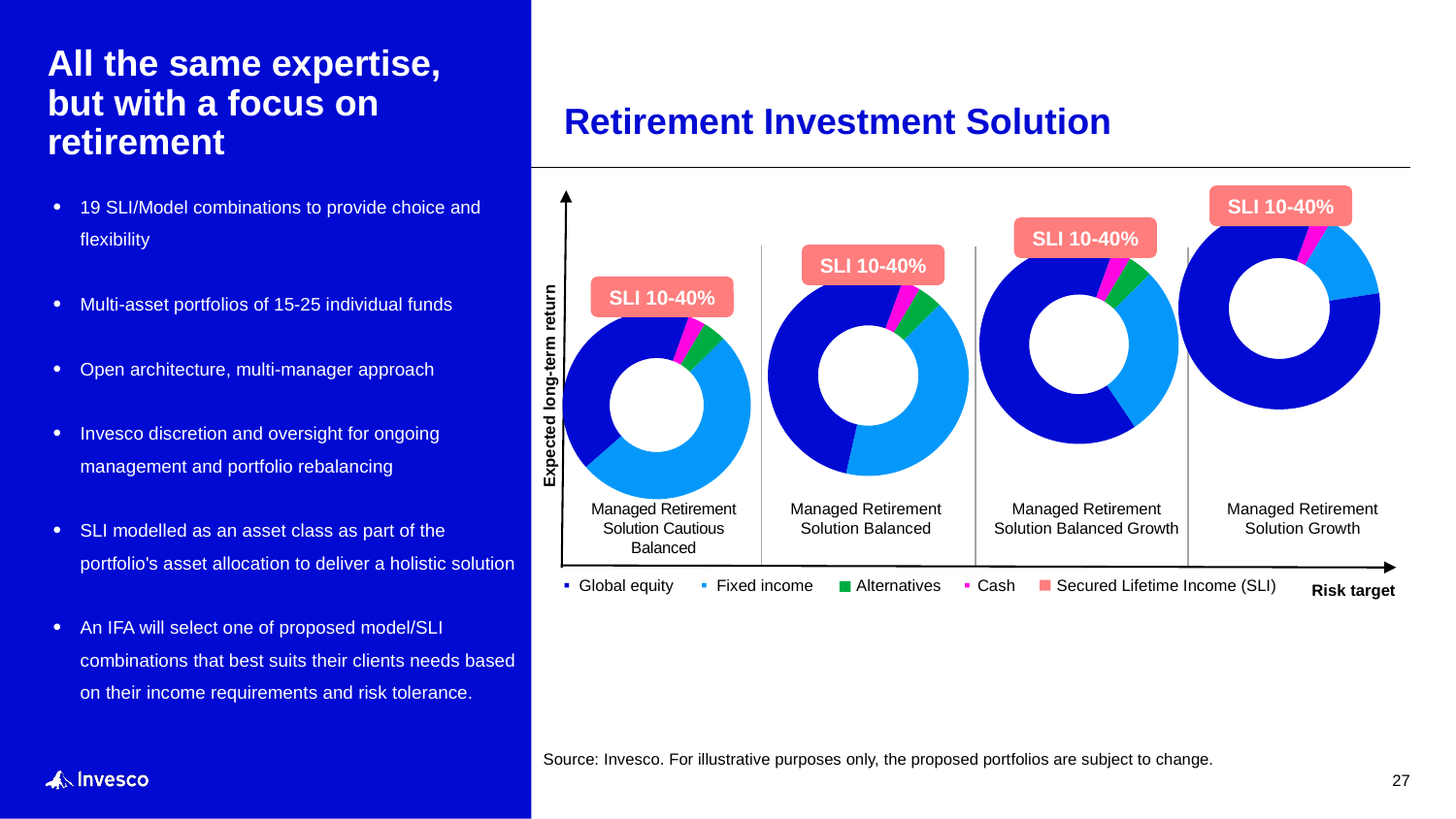
Which legend entry is shown in green? Alternatives In the Managed Retirement Solution Growth chart, which is larger: Global equity or Fixed income? Global equity How many portfolio charts are shown on the slide? 4 In the Managed Retirement Solution Growth chart, which asset class has the smallest slice? Cash In the Managed Retirement Solution Cautious Balanced chart, which is larger: Fixed income or Cash? Fixed income What is the title of the chart area on the slide? Retirement Investment Solution Across the four charts, which asset class has the largest slice in the Managed Retirement Solution Balanced Growth chart? Global equity What is the label of the vertical axis? Expected long-term return How many asset classes does the legend list? 5 What kind of chart is used for the Managed Retirement Solution Growth portfolio? Pie chart (donut) What label is shown above each of the four donut charts? SLI 10-40% Moving from the Cautious Balanced chart to the Growth chart along the Risk target axis, does the Global equity share rise or fall? Rise